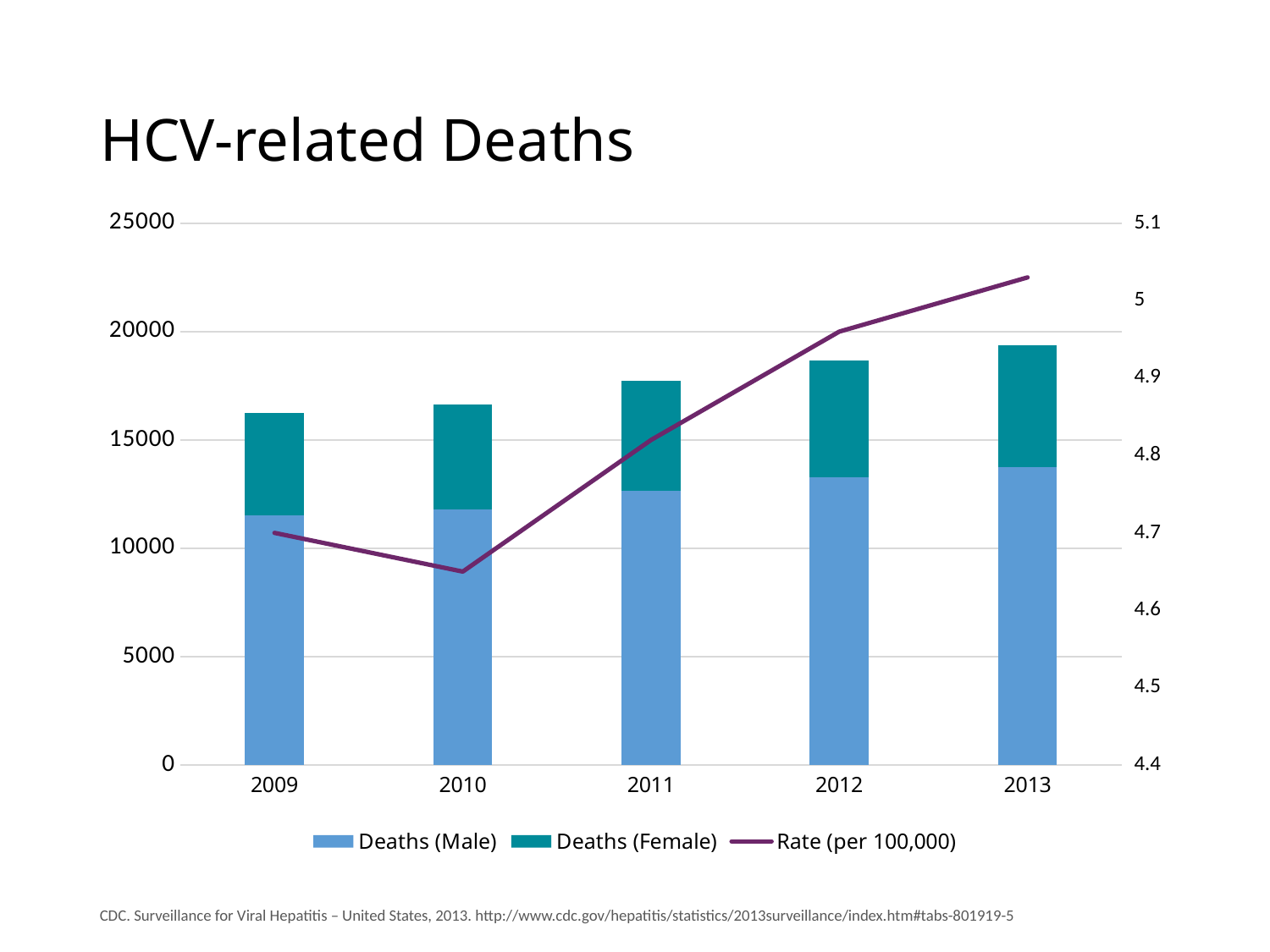
Is the value for Deaths (Male) in 2013 greater or less than 10000? greater What kind of chart is shown on the slide? A bar chart with a line Is the Rate (per 100,000) in 2013 greater or less than 5? greater How many series does the legend list? 3 Is the Rate (per 100,000) in 2010 greater or less than 4.7? less Which year has the shortest stacked bar of total deaths? 2009 Which year has the tallest stacked bar of total deaths? 2013 What is the title of the chart? HCV-related Deaths How many years are shown on the x axis? 5 Does the Rate (per 100,000) line rise or fall from 2010 to 2013? rise Which year has the lowest Rate (per 100,000)? 2010